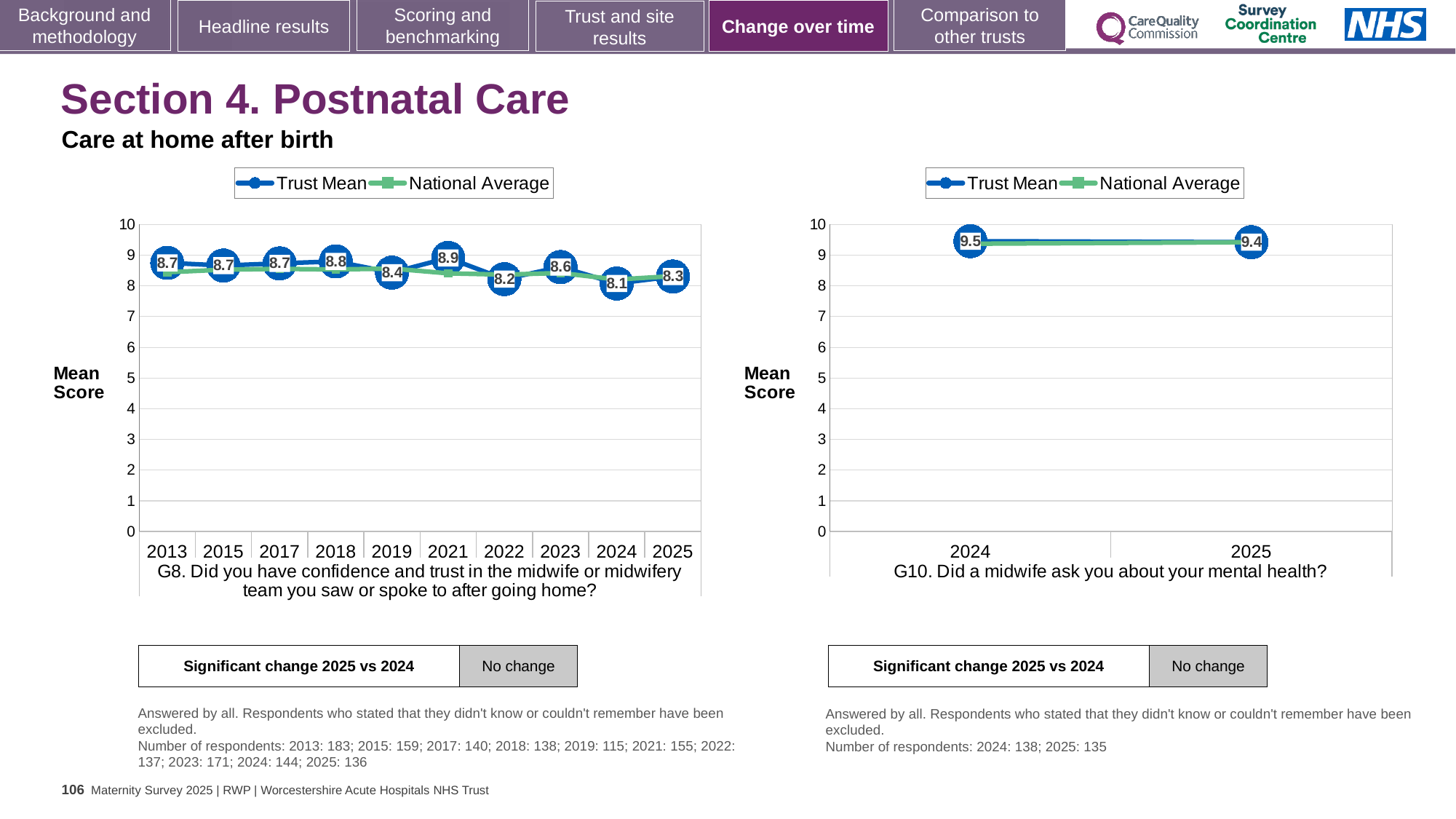
In the G8 chart on the left, what is the Trust Mean score for 2021? 8.9 In the G8 chart on the left, which year has the lowest Trust Mean score? 2024 In the G8 chart on the left, is the Trust Mean score for 2019 greater or less than 8? greater In the G10 chart on the right, what is the Trust Mean score for 2024? 9.5 In the G8 chart on the left, what is the Trust Mean score for 2025? 8.3 In the G10 chart on the right, which year has the larger Trust Mean score, 2024 or 2025? 2024 In the G8 chart on the left, which year has the highest Trust Mean score? 2021 In the G8 chart on the left, how many years are plotted on the x axis? 10 In the G8 chart on the left, what is the difference between the Trust Mean scores for 2021 and 2024? 0.8 In the G10 chart on the right, what is the difference between the Trust Mean scores for 2024 and 2025? 0.1 What kind of chart is the G8 chart on the left? Line chart How many series does the legend of the G10 chart on the right list? 2